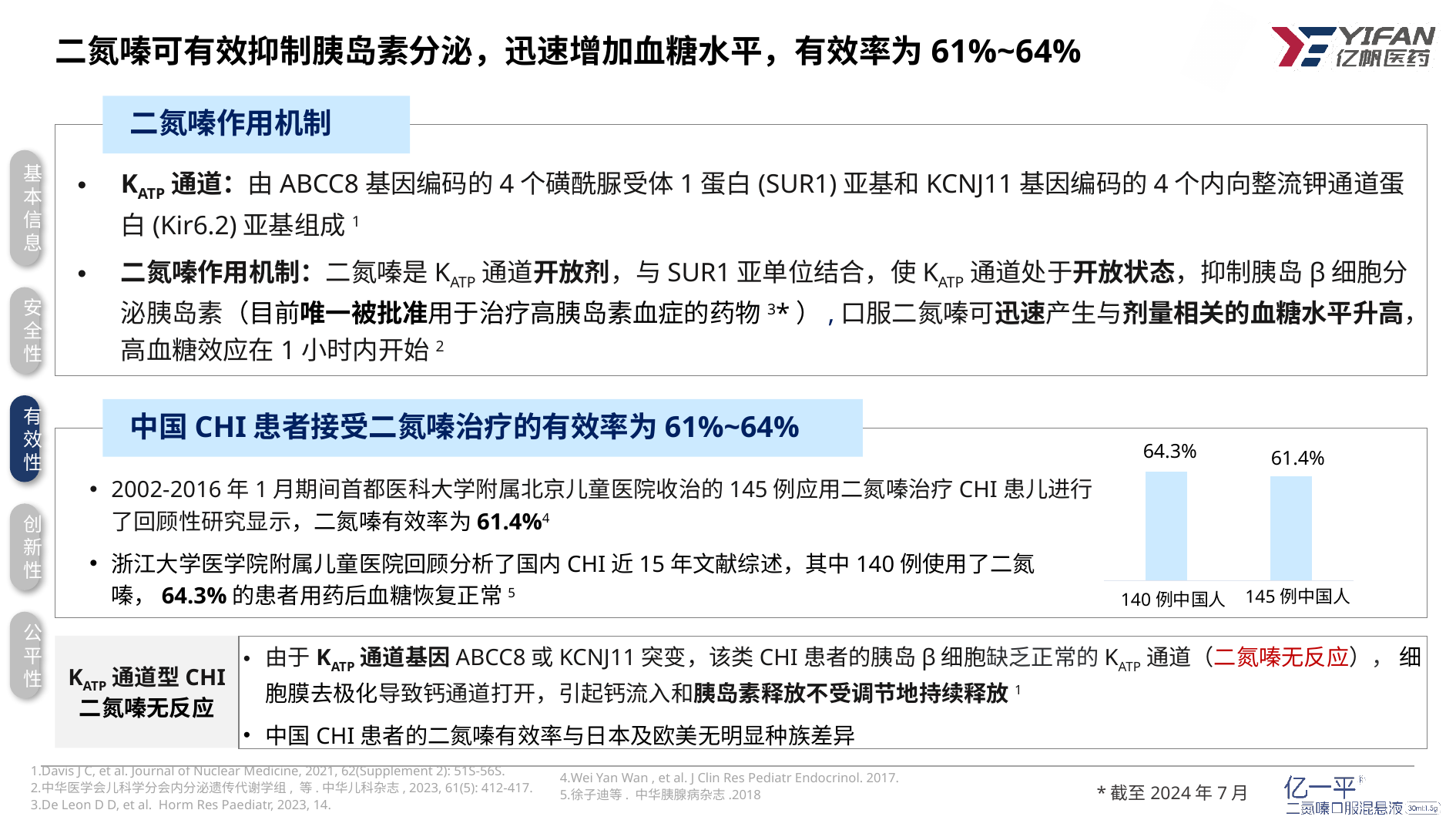
Which category has the lowest value in the bar chart? 145 例中国人 What kind of chart is shown on the slide? bar chart What is the difference between the values for 140 例中国人 and 145 例中国人 in the bar chart? 2.9% What is the value for 140 例中国人 in the bar chart? 64.3% Which is larger in the bar chart: the value for 140 例中国人 or the value for 145 例中国人? 140 例中国人 What is the value for 145 例中国人 in the bar chart? 61.4% What is the label of the left bar in the chart? 140 例中国人 What colour are the bars in the chart? light blue Do the values in the bar chart rise or fall from left to right? fall How many bars are shown in the chart? 2 Which category has the highest value in the bar chart? 140 例中国人